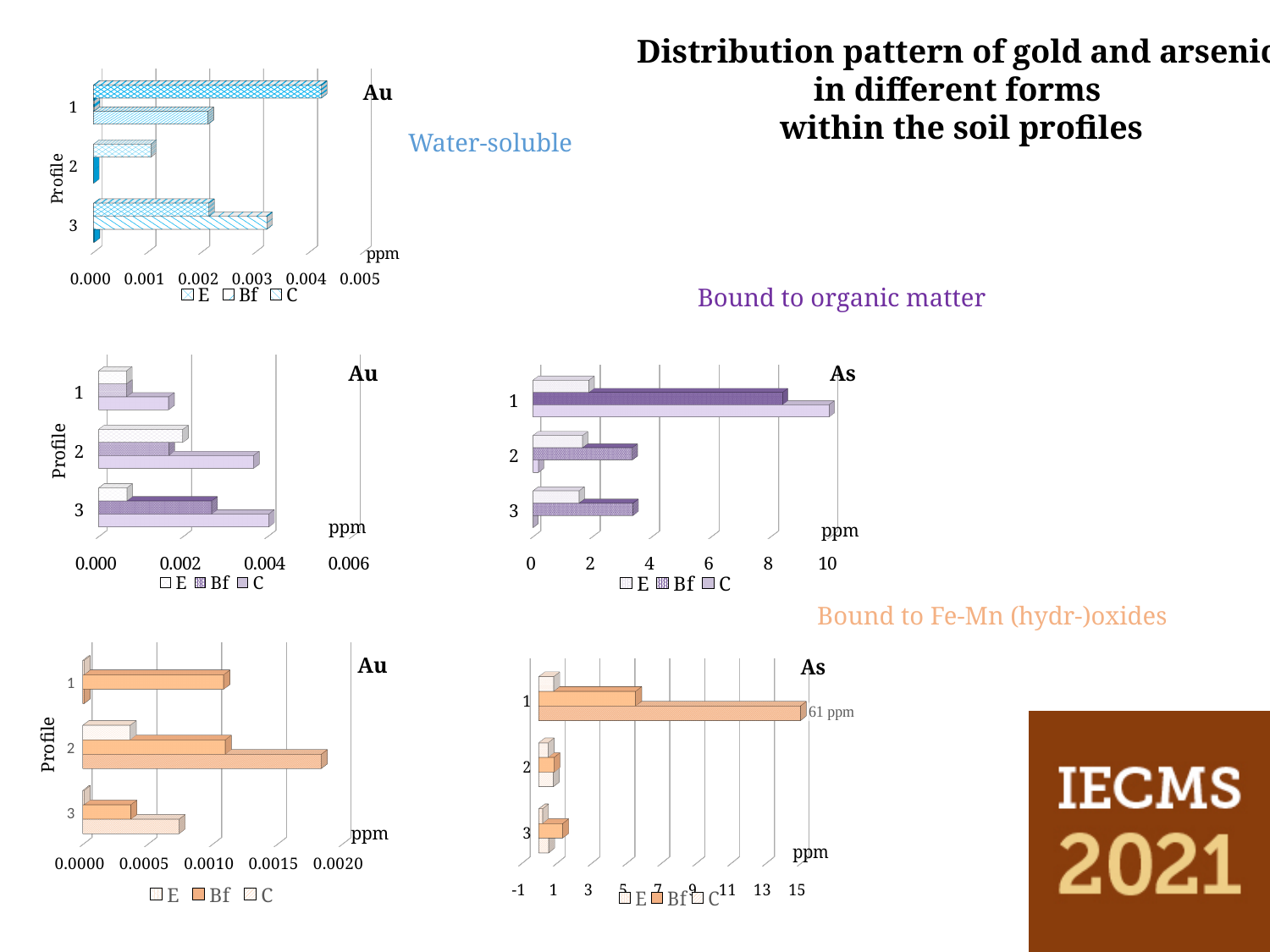
How many series does the legend list in the 'Bound to organic matter' As chart? 3 In the 'Water-soluble' Au chart, which profile has the highest value for series E? Profile 1 In the 'Bound to Fe-Mn (hydr-)oxides' As chart, what is the value for series C in profile 1? 61 ppm In the 'Bound to Fe-Mn (hydr-)oxides' As chart, is the value for series Bf in profile 3 greater or less than 3? less What kind of chart is the 'Bound to Fe-Mn (hydr-)oxides' Au chart? Bar chart How many profiles are shown on the y axis of the 'Water-soluble' Au chart? 3 In the 'Bound to organic matter' As chart, is the value for series C in profile 1 greater or less than 6? greater In the 'Bound to Fe-Mn (hydr-)oxides' As chart, which profile has the highest value for series C? Profile 1 In the 'Bound to Fe-Mn (hydr-)oxides' Au chart, which profile has the highest value for series C? Profile 2 In the 'Water-soluble' Au chart, is the value for series C in profile 2 greater or less than 0.001? less In the 'Bound to organic matter' As chart, which is larger: series C in profile 1 or series C in profile 2? Series C in profile 1